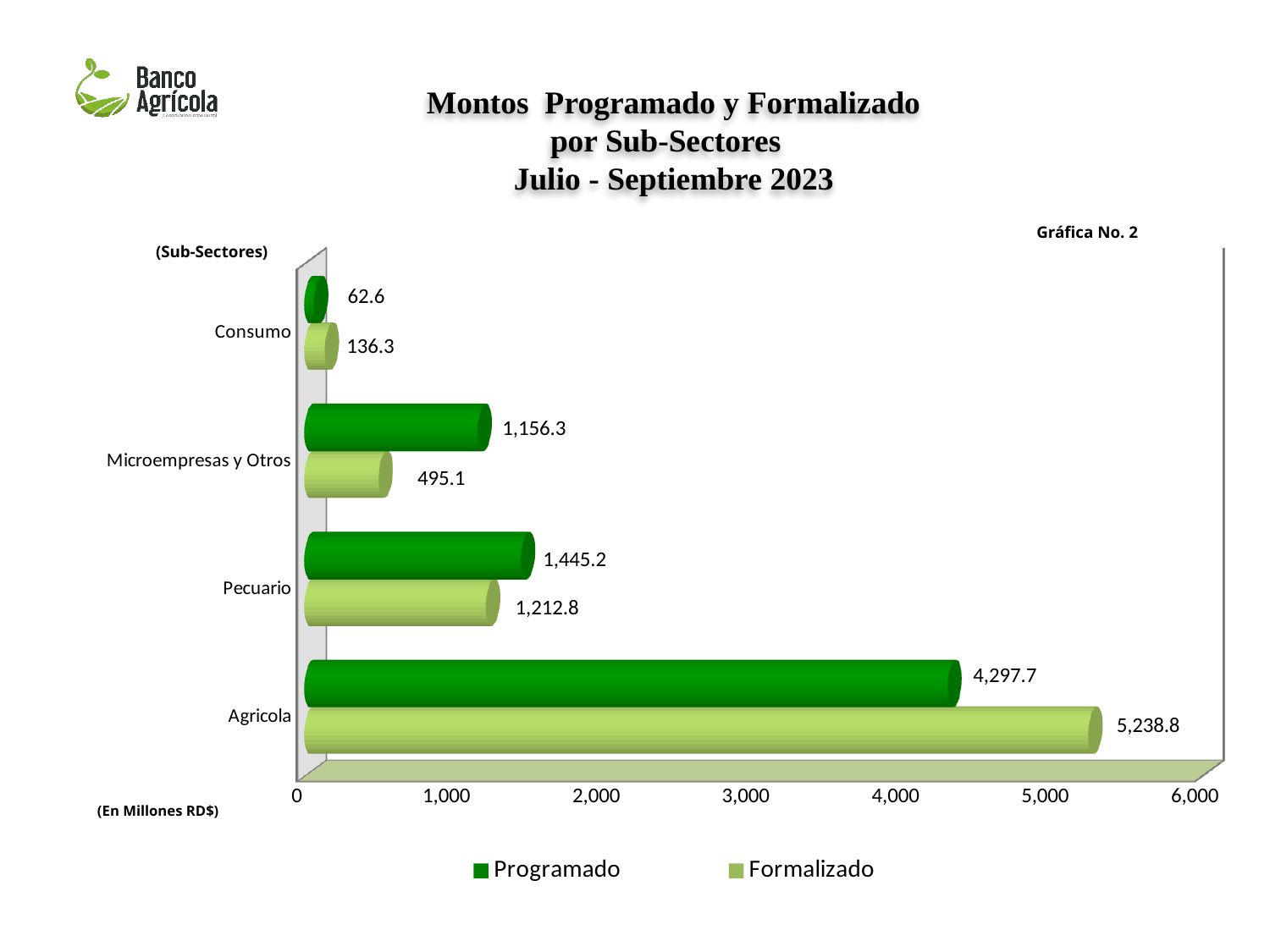
Which sub-sector has the lowest Programado value? Consumo What is the difference between the Programado and Formalizado values for Pecuario? 232.4 What is the Programado value for Agricola? 4,297.7 How many sub-sectors are shown on the chart? 4 What is the Formalizado value for Consumo? 136.3 How many series does the legend list? 2 What unit is stated for the values on the chart? En Millones RD$ Which sub-sector has the highest Formalizado value? Agricola For Microempresas y Otros, which is larger: Programado or Formalizado? Programado What is the difference between the Formalizado and Programado values for Agricola? 941.1 What kind of chart is shown on the slide? Bar chart What is the Formalizado value for Microempresas y Otros? 495.1